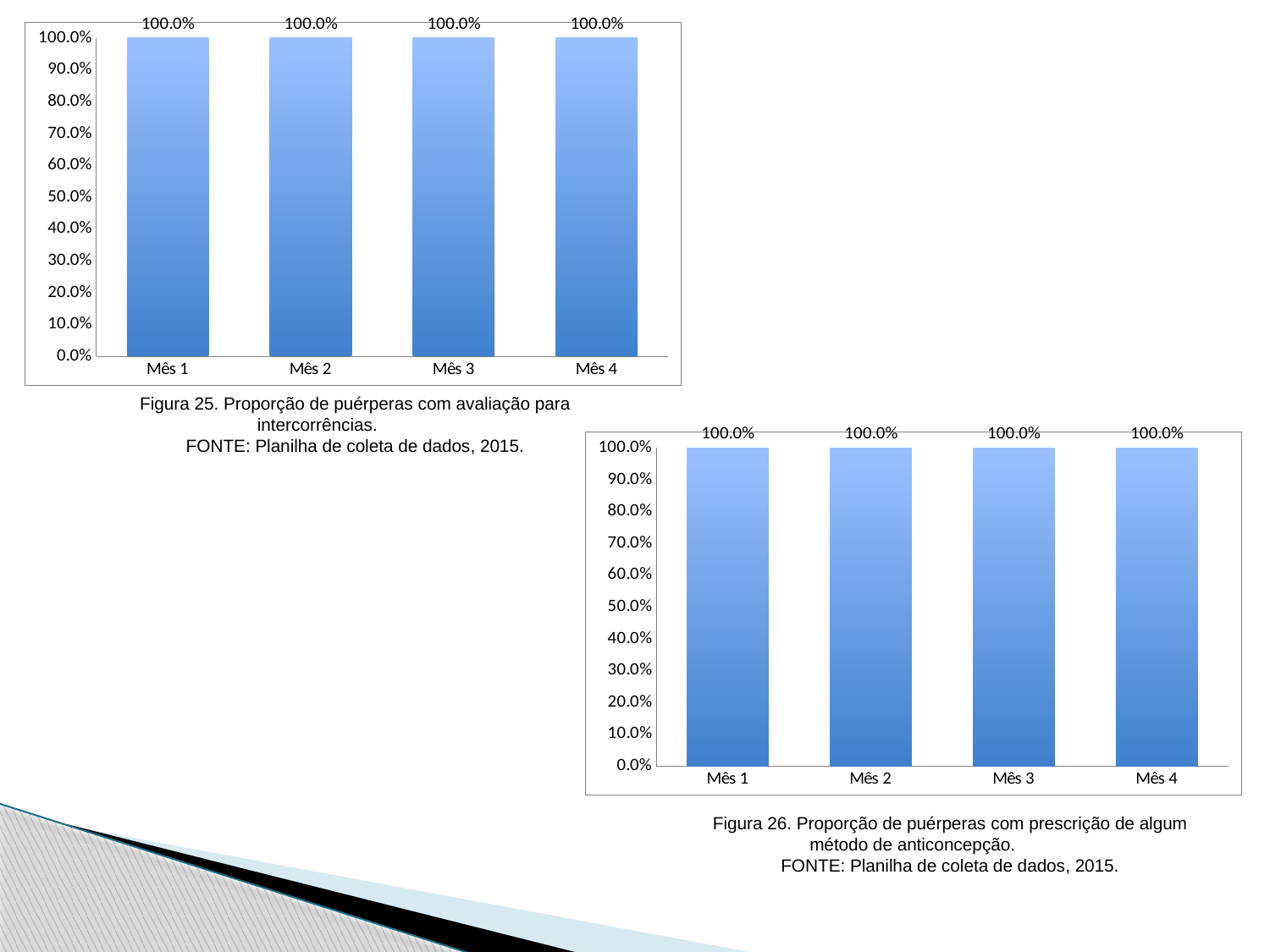
In the bottom-right chart (Figura 26), what is the value for Mês 3? 100.0% In the top-left chart (Figura 25), what is the difference between the values for Mês 1 and Mês 3? 0.0% How many categories are shown on the x axis of the top-left chart (Figura 25)? 4 In the top-left chart (Figura 25), what is the value for Mês 1? 100.0% What is the caption of the bottom-right chart? Figura 26. Proporção de puérperas com prescrição de algum método de anticoncepção. What kind of chart is the top-left chart (Figura 25)? Bar chart How many bars are plotted in the bottom-right chart (Figura 26)? 4 In the top-left chart (Figura 25), what is the value for Mês 4? 100.0% In the top-left chart (Figura 25), is the value for Mês 2 greater or less than 50.0%? greater What kind of chart is the bottom-right chart (Figura 26)? Bar chart In the bottom-right chart (Figura 26), what is the value for Mês 2? 100.0% In the bottom-right chart (Figura 26), do the values rise, fall, or stay the same from Mês 1 to Mês 4? Stay the same